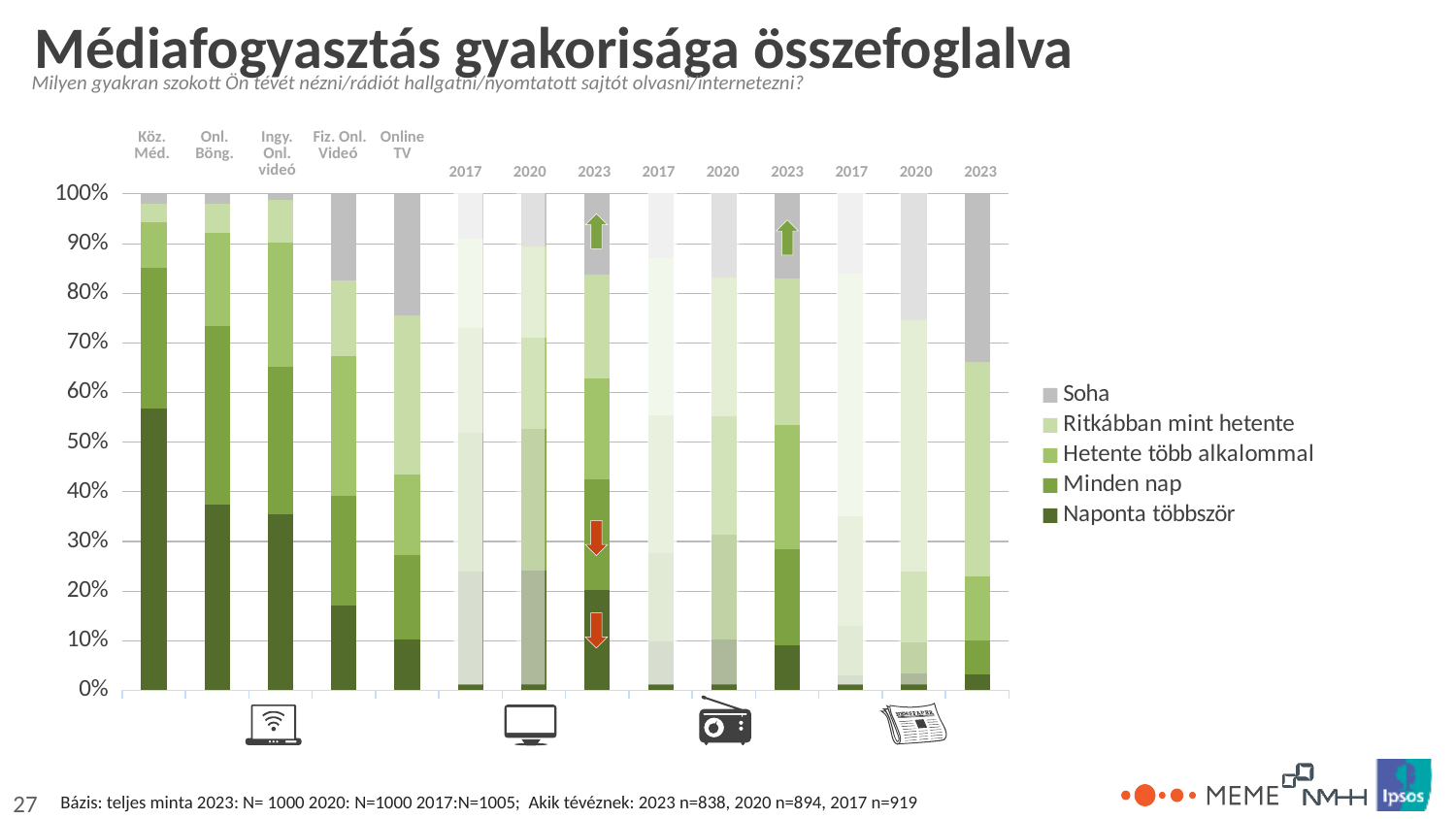
Is the 'Naponta többször' value for Fiz. Onl. Videó greater or less than 20%? less Is the 'Naponta többször' value for Online TV greater or less than 20%? less Which legend entry is listed first (at the top of the legend)? Soha What kind of chart is shown on the slide? Stacked bar chart How many series does the legend list? 5 Among the five named categories (Köz. Méd., Onl. Böng., Ingy. Onl. videó, Fiz. Onl. Videó, Online TV), which has the smallest 'Naponta többször' segment? Online TV Which has the larger 'Naponta többször' value, Köz. Méd. or Online TV? Köz. Méd. Is the 'Naponta többször' value for Ingy. Onl. videó greater or less than 30%? greater How many bars are plotted in the chart in total? 14 Among the five named categories (Köz. Méd., Onl. Böng., Ingy. Onl. videó, Fiz. Onl. Videó, Online TV), which has the largest 'Naponta többször' segment? Köz. Méd.